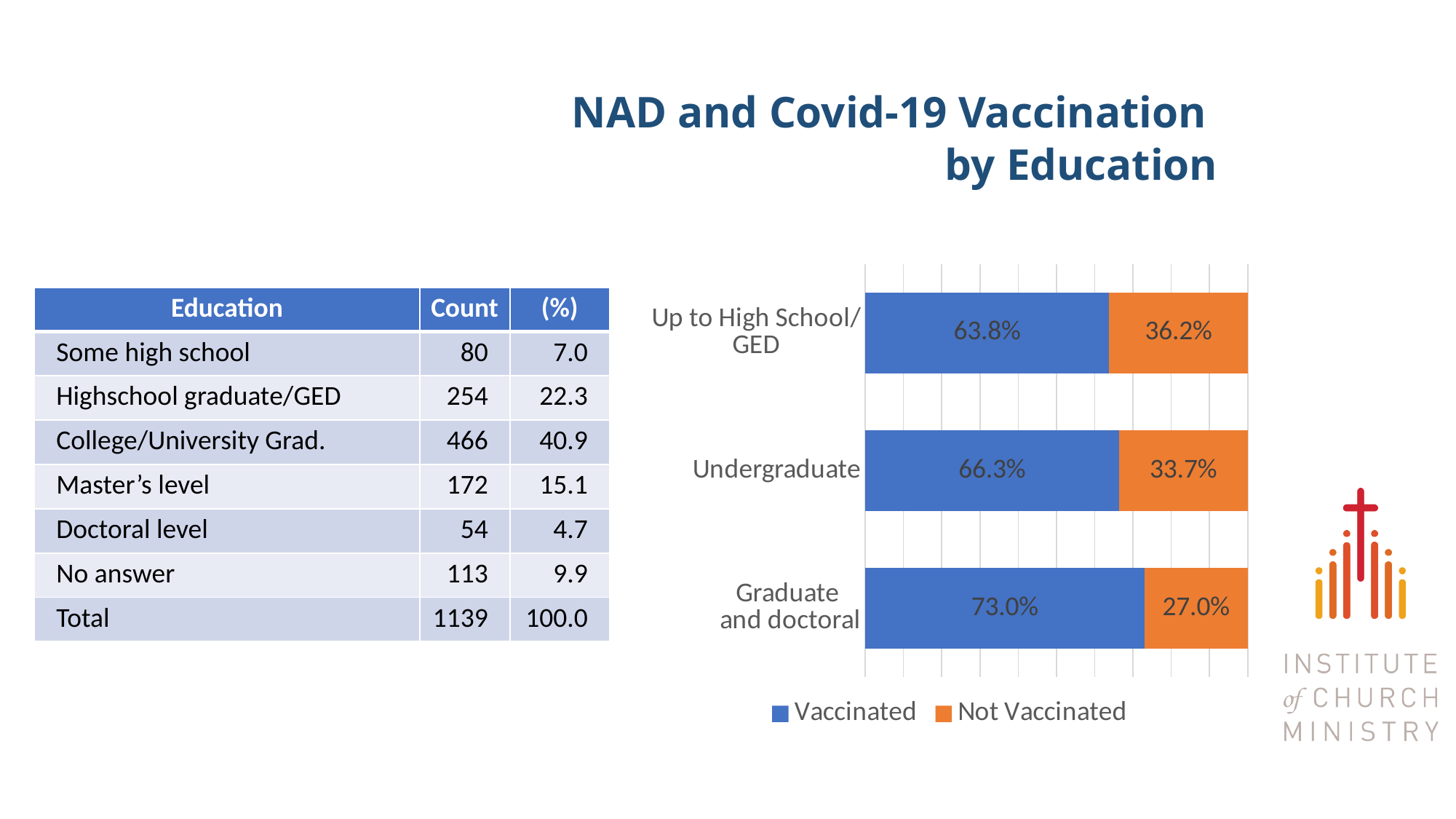
What is the Vaccinated value for Undergraduate? 66.3% What kind of chart is shown on the slide? Stacked bar chart Which is larger, the Not Vaccinated value for Undergraduate or for Graduate and doctoral? Undergraduate Which education category has the highest Vaccinated value? Graduate and doctoral What is the total of the stacked bar for Undergraduate? 100.0% Which education category has the lowest Vaccinated value? Up to High School/GED How many education categories are shown in the chart? 3 What is the difference between the Vaccinated values for Graduate and doctoral and Up to High School/GED? 9.2% Which colour represents the Not Vaccinated series in the chart? Orange How many series does the chart legend list? 2 What is the Vaccinated value for Graduate and doctoral? 73.0% What is the Not Vaccinated value for Up to High School/GED? 36.2%